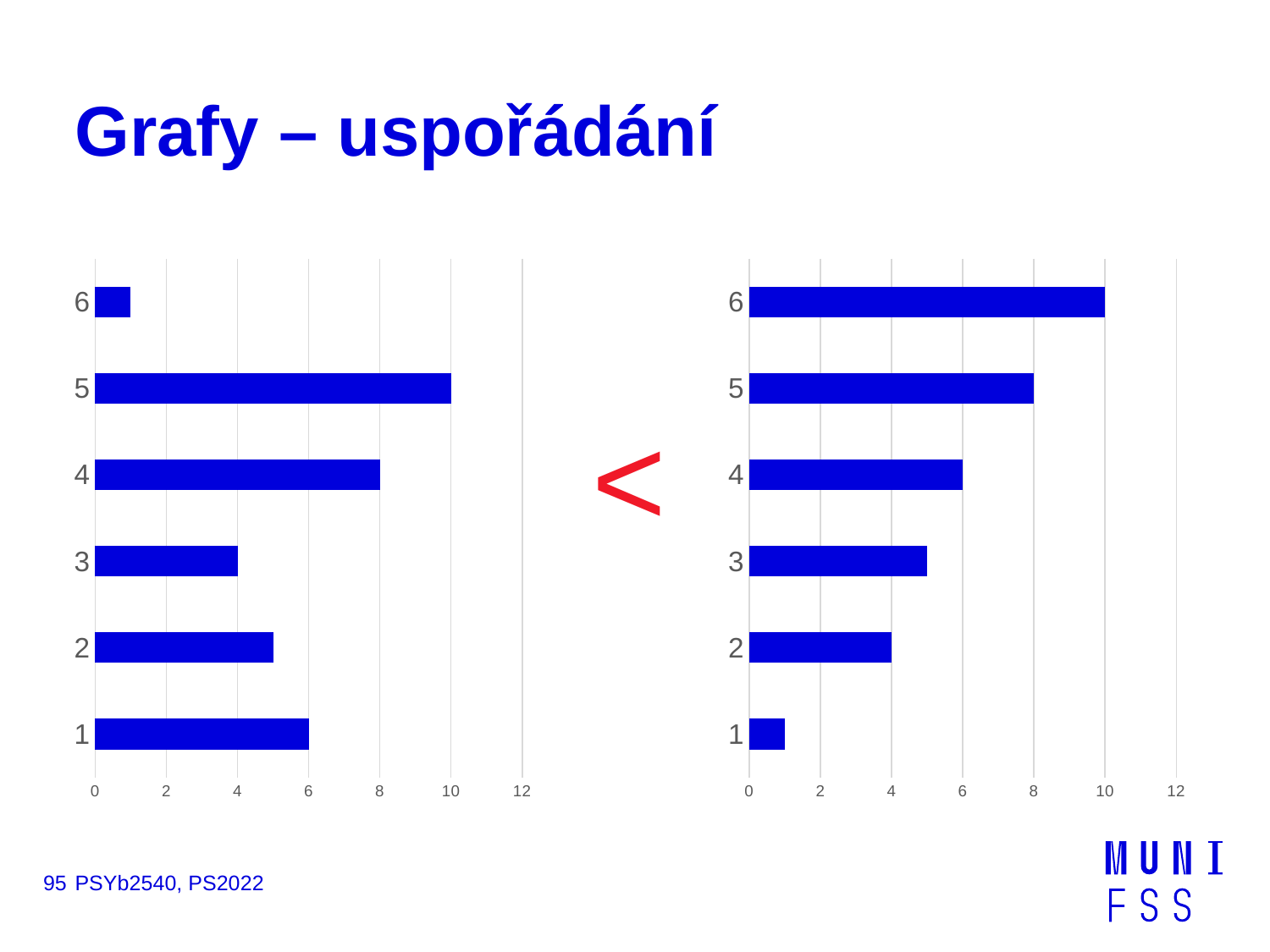
In the chart on the right, is the value for category 3 greater or less than 6? less In the chart on the left, which category has the lowest value? 6 In the chart on the left, which category has the highest value? 5 In the chart on the left, what is the value for category 4? 8 In the chart on the left, what is the difference between the values for category 5 and category 4? 2 In the chart on the right, what is the value for category 6? 10 What kind of chart is the chart on the left of the slide? bar chart In the chart on the left, what is the value for category 1? 6 How many categories does the chart on the right show? 6 In the chart on the left, is the value for category 2 greater or less than 4? greater In the chart on the left, what is the value for category 5? 10 In the chart on the right, which category has the lowest value? 1